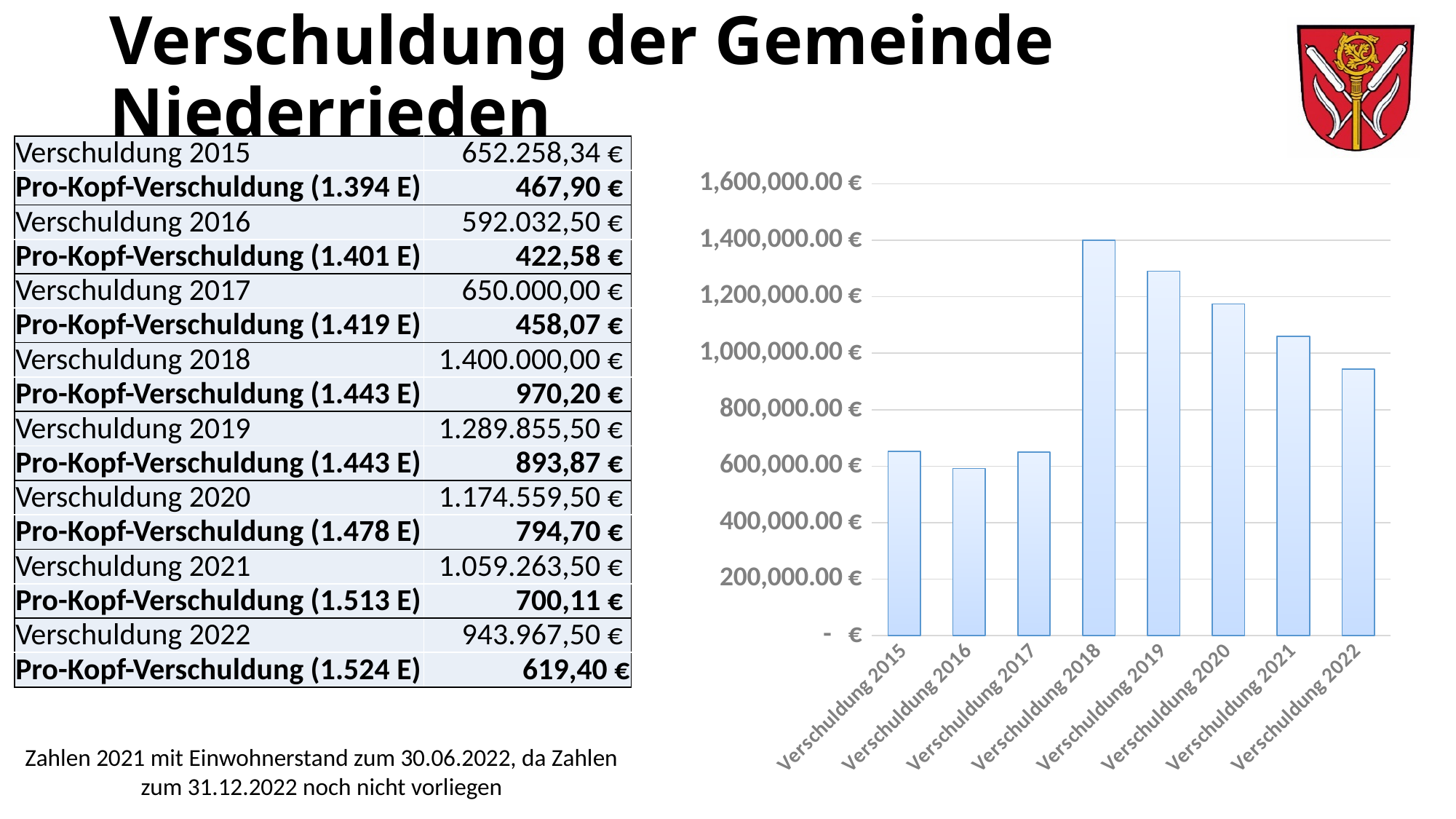
Is the value for Verschuldung 2016 greater or less than 600,000.00 €? less Which is larger, the bar for Verschuldung 2019 or the bar for Verschuldung 2020? Verschuldung 2019 Using the values in the table, what is the difference between Verschuldung 2018 and Verschuldung 2019? 110.144,50 € Do the bars rise or fall from Verschuldung 2018 to Verschuldung 2022? fall What kind of chart is shown on the slide? bar chart Which category has the lowest bar in the chart? Verschuldung 2016 Which category has the highest bar in the chart? Verschuldung 2018 How many bars (categories) does the chart show? 8 According to the table on the slide, what is the value of Verschuldung 2018? 1.400.000,00 € According to the table on the slide, what is the value of Verschuldung 2022? 943.967,50 € Is the value for Verschuldung 2021 greater or less than 1,000,000.00 €? greater Is the value for Verschuldung 2022 greater or less than 800,000.00 €? greater